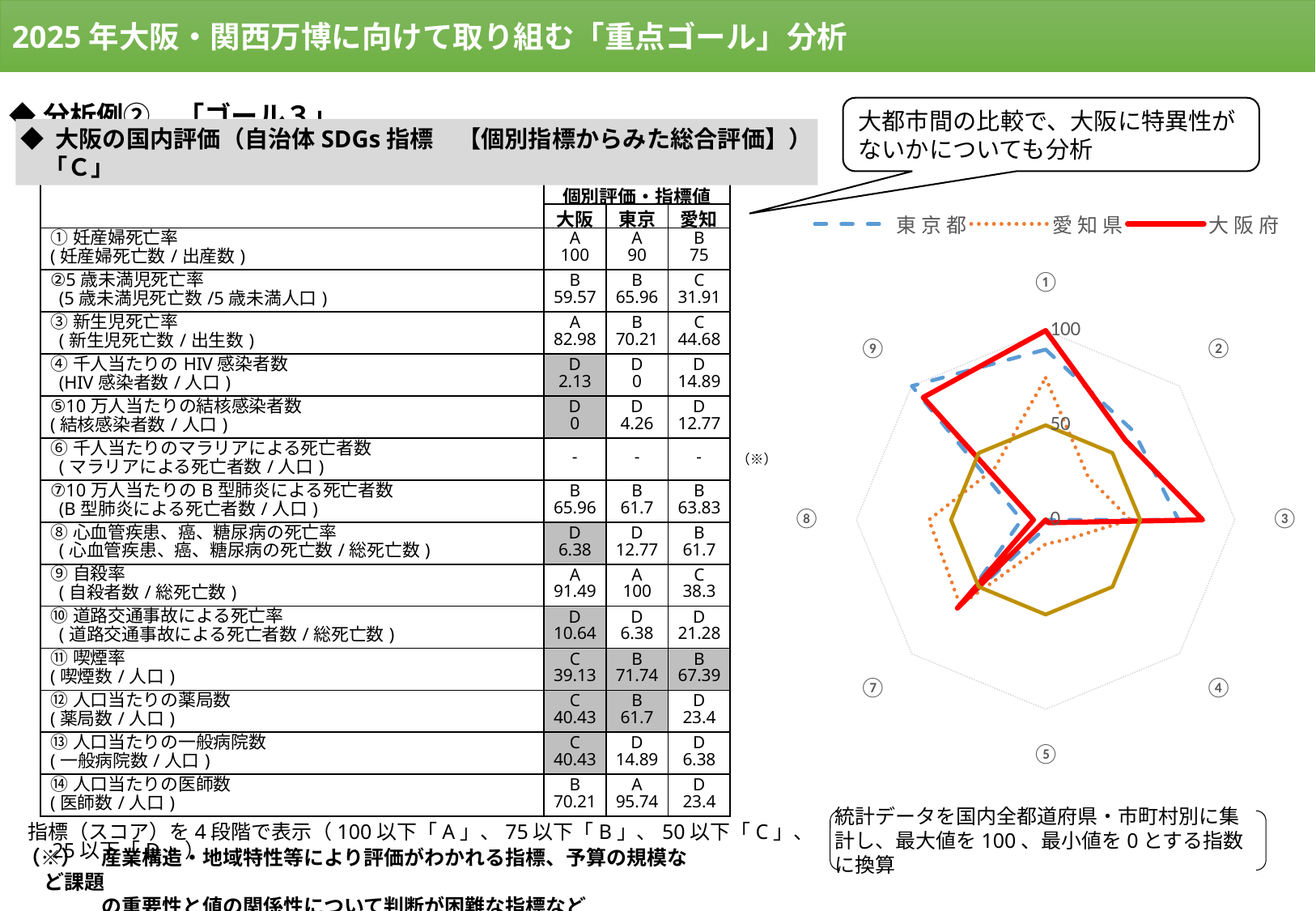
In the radar chart, which series has the highest value on axis ①? 大阪府 Which three series are listed in the legend of the radar chart? 東京都, 愛知県, 大阪府 In the radar chart, is the value for 大阪府 on axis ⑧ greater or less than 50? less In the radar chart, is the value for 大阪府 on axis ③ greater or less than 50? greater In the radar chart, is the value for 愛知県 on axis ⑧ greater or less than 50? greater What is the highest value shown on the radial axis of the radar chart? 100 How many axes (numbered categories) does the radar chart have? 8 What kind of chart is shown on the right side of the slide? Radar chart How many series does the legend of the radar chart list? 3